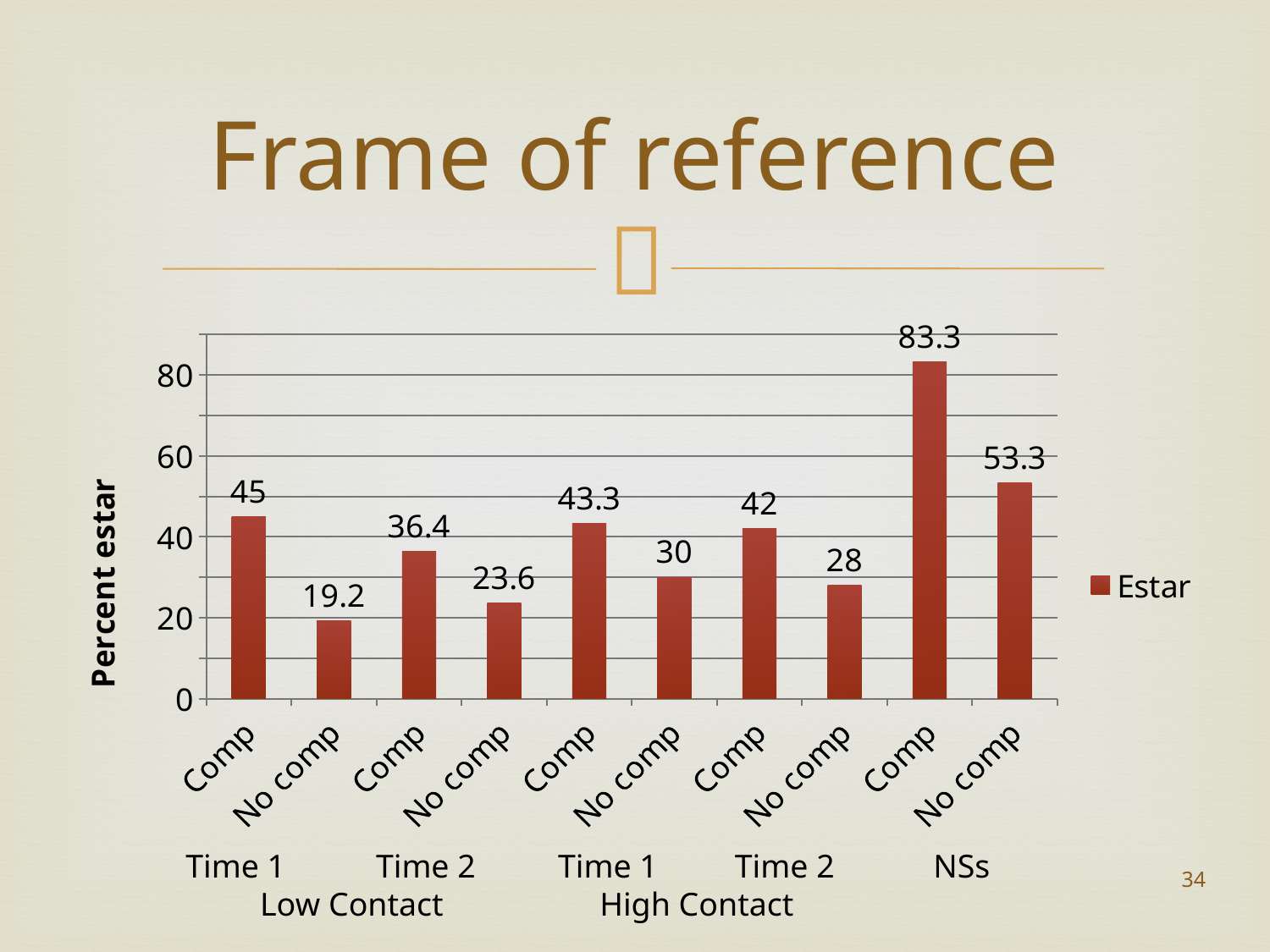
What is the difference between the Comp and No comp values in the NSs group? 30 What is the value for No comp at Time 2 in the Low Contact group? 23.6 What is the value for Comp at Time 1 in the Low Contact group? 45 Which bar has the highest value? Comp (NSs) What kind of chart is shown on the slide? Bar chart Which is larger: No comp at Time 1 in the High Contact group or No comp at Time 2 in the High Contact group? No comp at Time 1 in the High Contact group What is the difference between the Comp values at Time 1 and Time 2 in the Low Contact group? 8.6 What is the label of the vertical axis? Percent estar What is the value for Comp at Time 2 in the High Contact group? 42 How many bars are plotted in the chart? 10 Which bar has the lowest value? No comp (Time 1, Low Contact) What is the value for No comp in the NSs group? 53.3